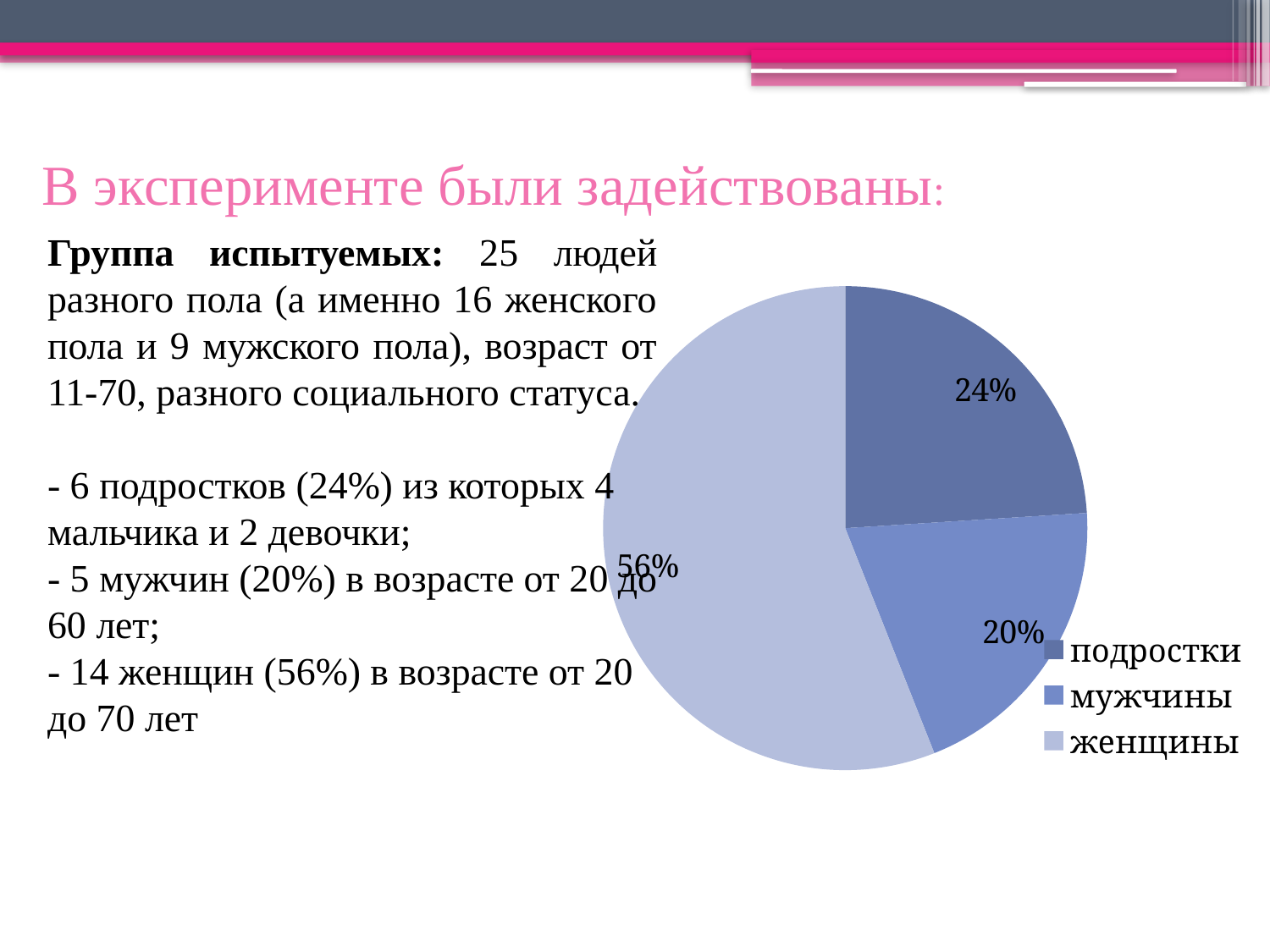
What is the difference in percentage points between the "подростки" slice and the "мужчины" slice? 4% What kind of chart is shown on the slide? pie chart What share of the pie does the "мужчины" slice represent? 20% Which category has the largest slice of the pie? женщины Which slice is larger, "подростки" or "мужчины"? подростки What is the difference in percentage points between the "женщины" slice and the "подростки" slice? 32% How many categories does the pie chart have? 3 Which legend entry is shown with the lightest colour? женщины What share of the pie does the "женщины" slice represent? 56% How many entries does the legend list? 3 Which category has the smallest slice of the pie? мужчины What share of the pie does the "подростки" slice represent? 24%